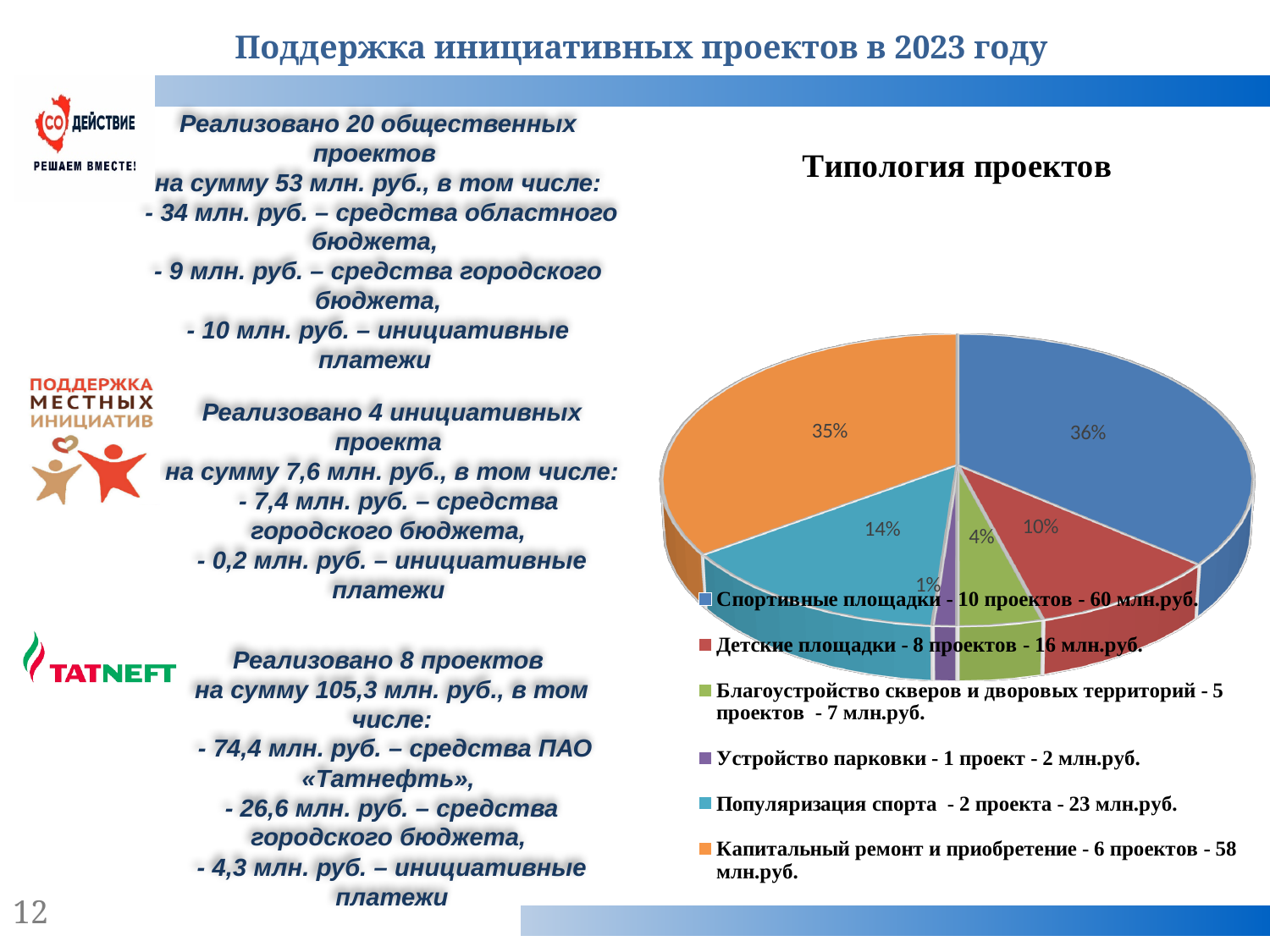
What kind of chart is shown under the title "Типология проектов"? Pie chart What percentage is shown for the slice "Популяризация спорта - 2 проекта - 23 млн.руб."? 14% How many slices does the pie chart have? 6 What percentage is shown for the slice "Капитальный ремонт и приобретение - 6 проектов - 58 млн.руб."? 35% What percentage is shown for the slice "Детские площадки - 8 проектов - 16 млн.руб."? 10% Which slice is larger: "Благоустройство скверов и дворовых территорий" or "Детские площадки"? Детские площадки What percentage is shown for the slice "Устройство парковки - 1 проект - 2 млн.руб."? 1% Which slice of the pie chart has the smallest share? Устройство парковки - 1 проект - 2 млн.руб. What is the difference in percentage points between the "Популяризация спорта" slice and the "Детские площадки" slice? 4 Which slice of the pie chart has the largest share? Спортивные площадки - 10 проектов - 60 млн.руб. What percentage of the pie is labelled for the slice "Спортивные площадки - 10 проектов - 60 млн.руб."? 36% What is the title of the chart on the slide? Типология проектов